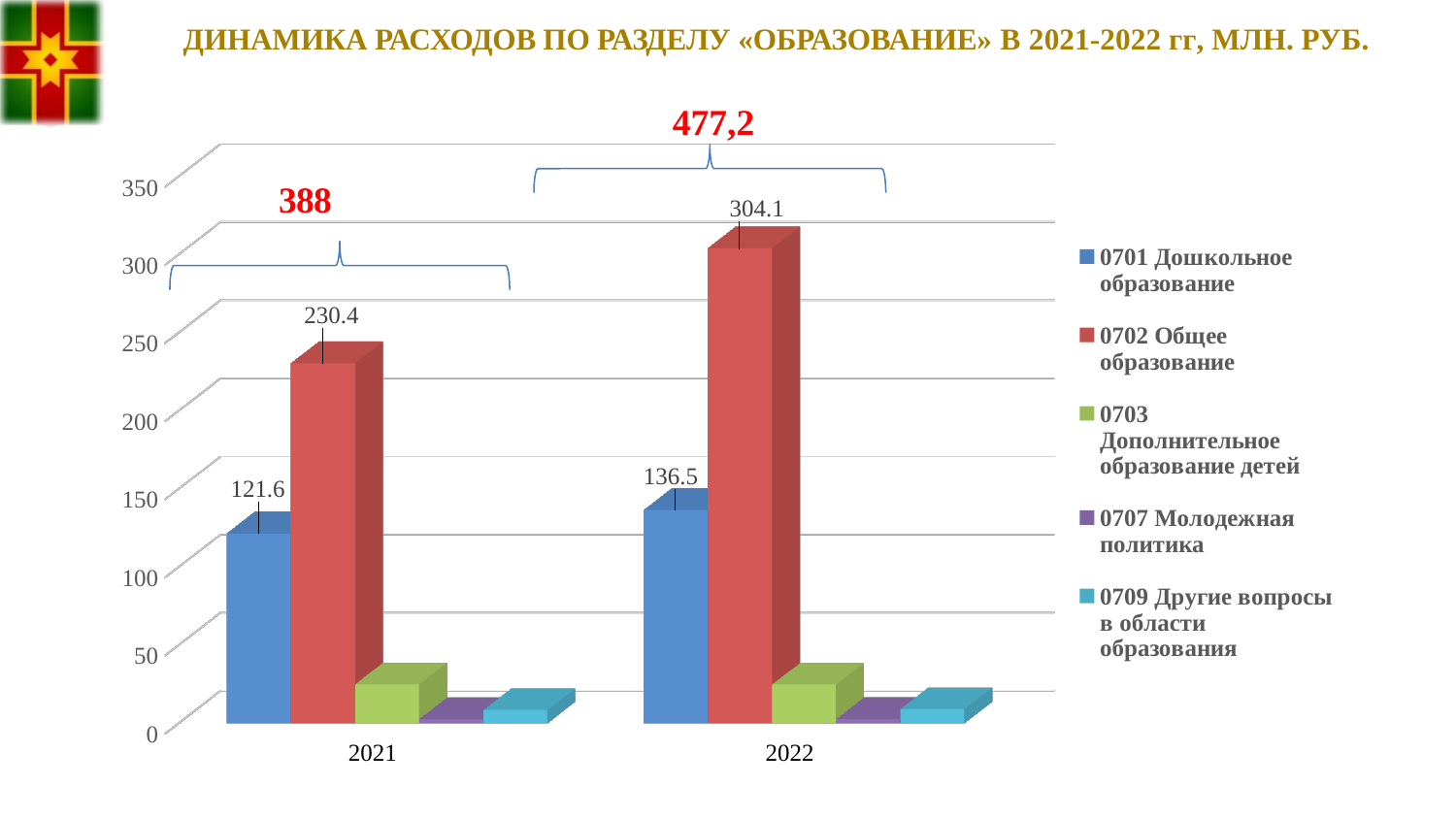
What is the value for 0701 Дошкольное образование in 2021? 121.6 What is the difference between the 0702 Общее образование and 0701 Дошкольное образование values in 2021? 108.8 Which is larger: 0701 Дошкольное образование in 2021 or in 2022? 2022 What is the value for 0702 Общее образование in 2022? 304.1 What is the difference between the 0702 Общее образование values for 2022 and 2021? 73.7 Is the value for 0703 Дополнительное образование детей in 2022 greater or less than 50? less What is the value for 0702 Общее образование in 2021? 230.4 Which series has the highest value in 2022? 0702 Общее образование What is the value for 0701 Дошкольное образование in 2022? 136.5 What kind of chart is shown on the slide? bar chart What total is annotated above the 2022 group of bars? 477,2 How many series does the legend list? 5